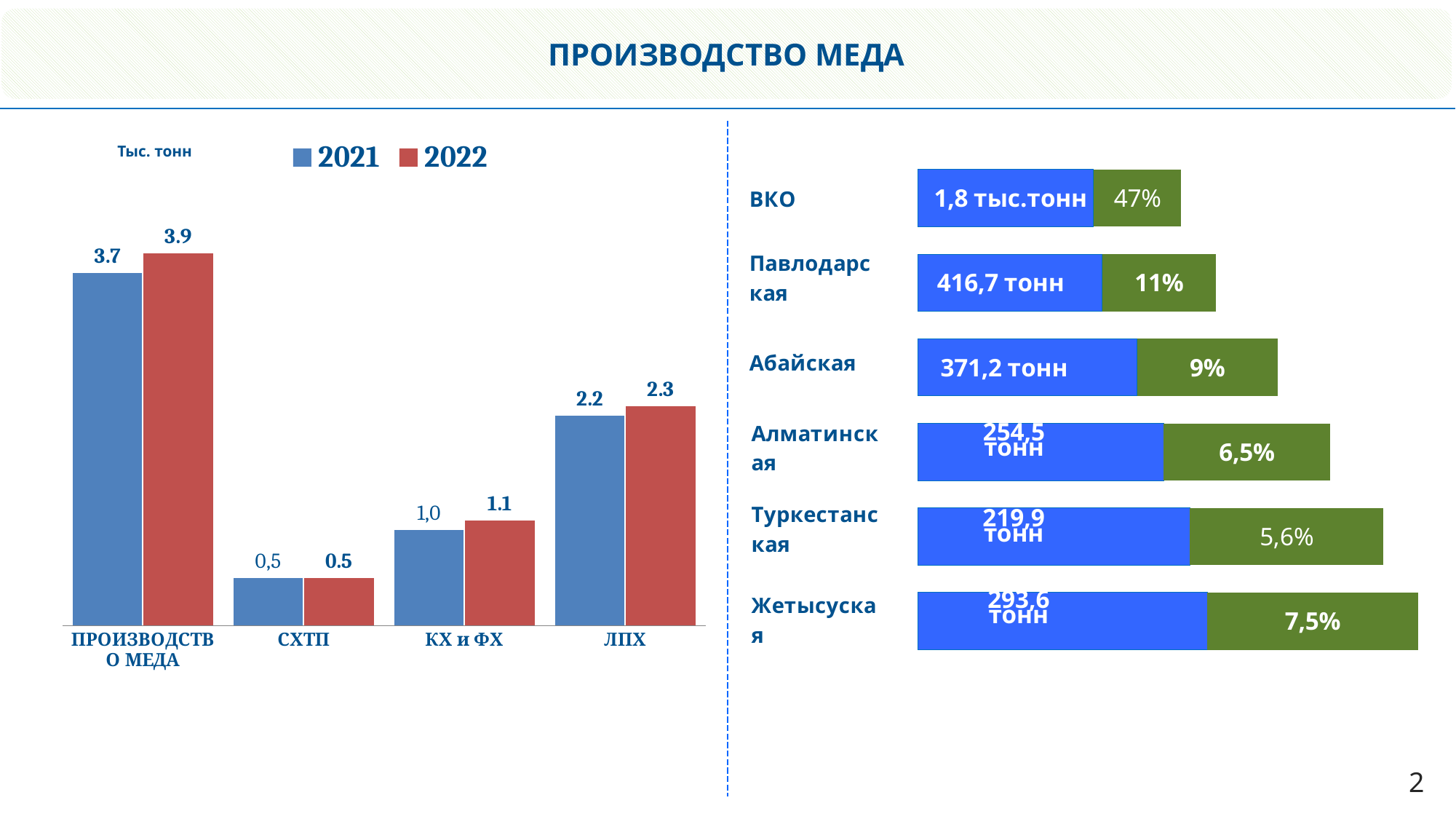
In the bar chart on the left, what unit is indicated above the chart? Тыс. тонн In the bar chart on the left, what is the difference between the 2022 and 2021 values for ПРОИЗВОДСТВО МЕДА? 0.2 In the bar chart on the left, which category has the highest value in 2021? ПРОИЗВОДСТВО МЕДА In the bar chart on the left, how many series does the legend list? 2 In the bar chart on the left, which category has the lowest value in 2022? СХТП In the bar chart on the left, which is larger: the 2022 value for ЛПХ or the 2022 value for КХ и ФХ? ЛПХ What type of chart is shown on the left side of the slide? Bar chart In the bar chart on the left, how many categories are shown on the x axis? 4 In the bar chart on the left, what is the value for КХ и ФХ in 2021? 1,0 In the regional graphic on the right, what percentage is shown for ВКО? 47% In the bar chart on the left, what is the value for ЛПХ in 2022? 2.3 In the bar chart on the left, what is the value for ПРОИЗВОДСТВО МЕДА in 2021? 3.7